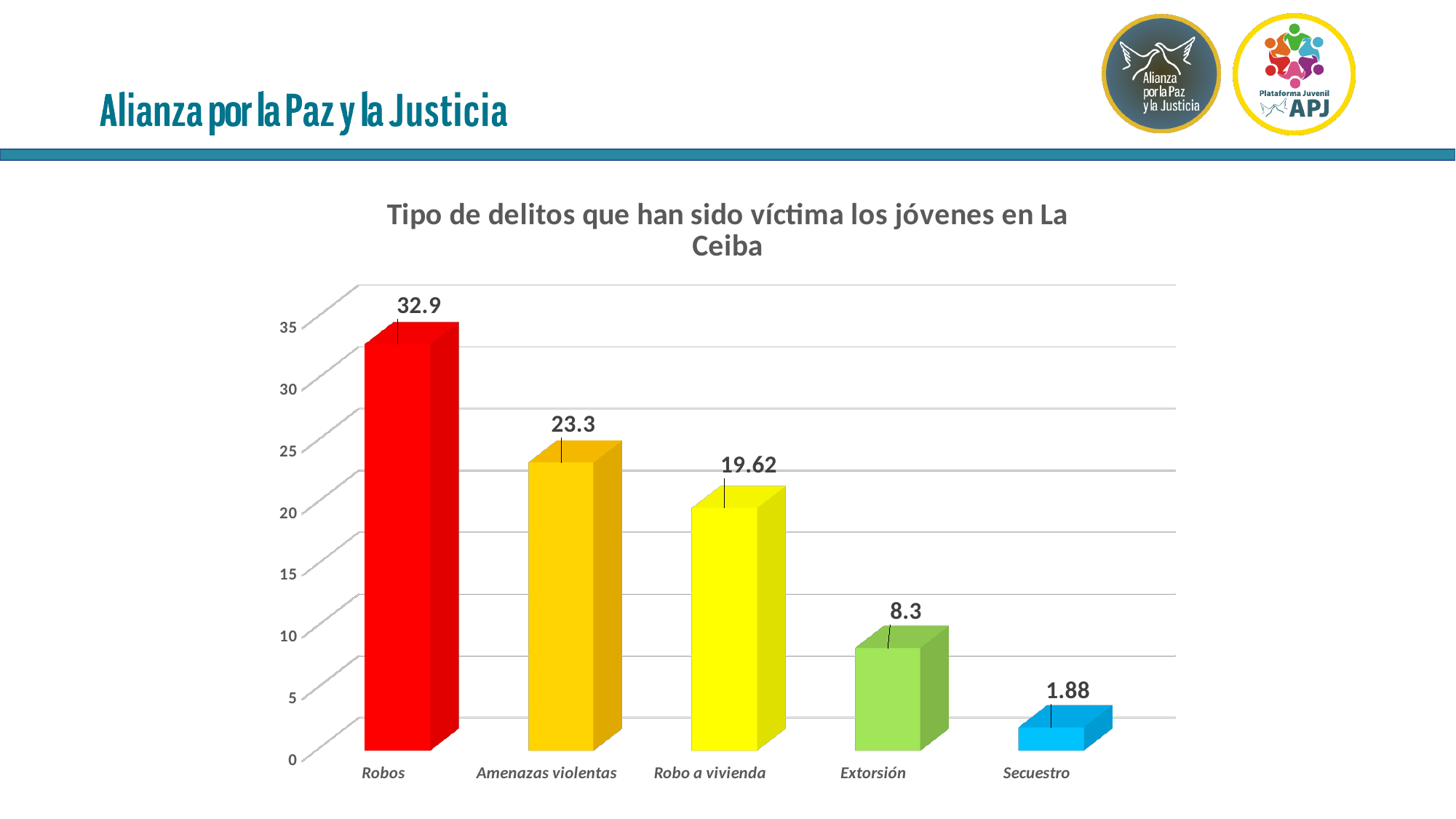
What is the title of the chart? Tipo de delitos que han sido víctima los jóvenes en La Ceiba What is the value for Amenazas violentas? 23.3 Which category has the lowest value? Secuestro How many categories are shown on the chart? 5 Is the value for Extorsión greater or less than 10? less Which category has the highest value? Robos What is the value for Robo a vivienda? 19.62 What is the value for Secuestro? 1.88 Which is larger, the value for Extorsión or the value for Robo a vivienda? Robo a vivienda What is the value for Robos? 32.9 What kind of chart is shown on the slide? bar chart What is the difference between the values for Robos and Amenazas violentas? 9.6